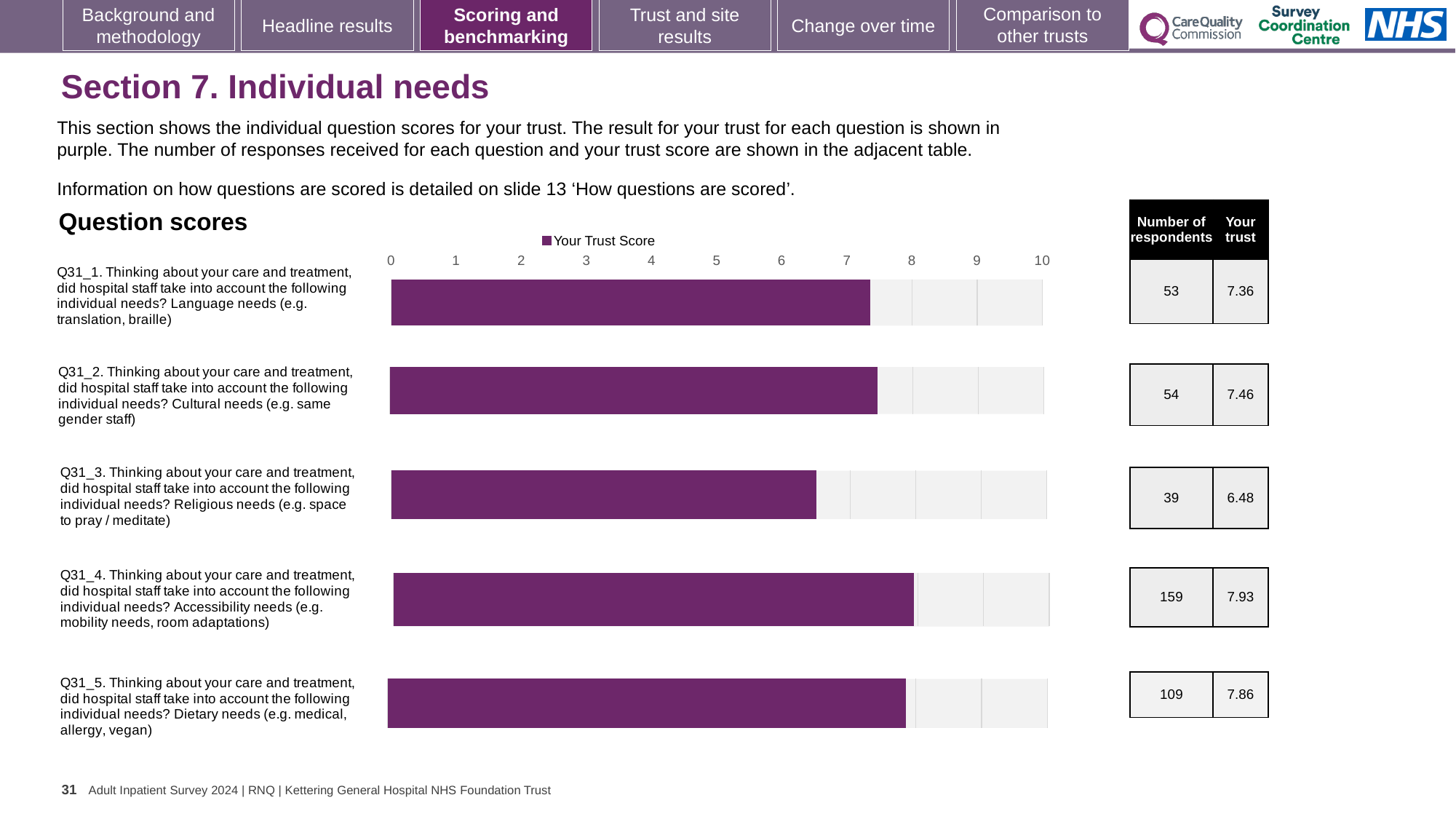
Is the trust score for Q31_3 (Religious needs) greater or less than 7? less What is the trust score for Q31_3 (Religious needs)? 6.48 What is the difference between the trust scores for Q31_4 (Accessibility needs) and Q31_3 (Religious needs)? 1.45 What is the maximum value shown on the x axis of the Question scores chart? 10 Which question has the highest trust score? Q31_4 (Accessibility needs) Which has the larger trust score, Q31_2 (Cultural needs) or Q31_5 (Dietary needs)? Q31_5 (Dietary needs) What kind of chart is used to show the question scores? Bar chart What is the trust score for Q31_4 (Accessibility needs)? 7.93 How many series does the legend of the Question scores chart list? 1 What is the trust score for Q31_1 (Language needs)? 7.36 Which question has the lowest trust score? Q31_3 (Religious needs) How many questions are plotted in the Question scores chart? 5